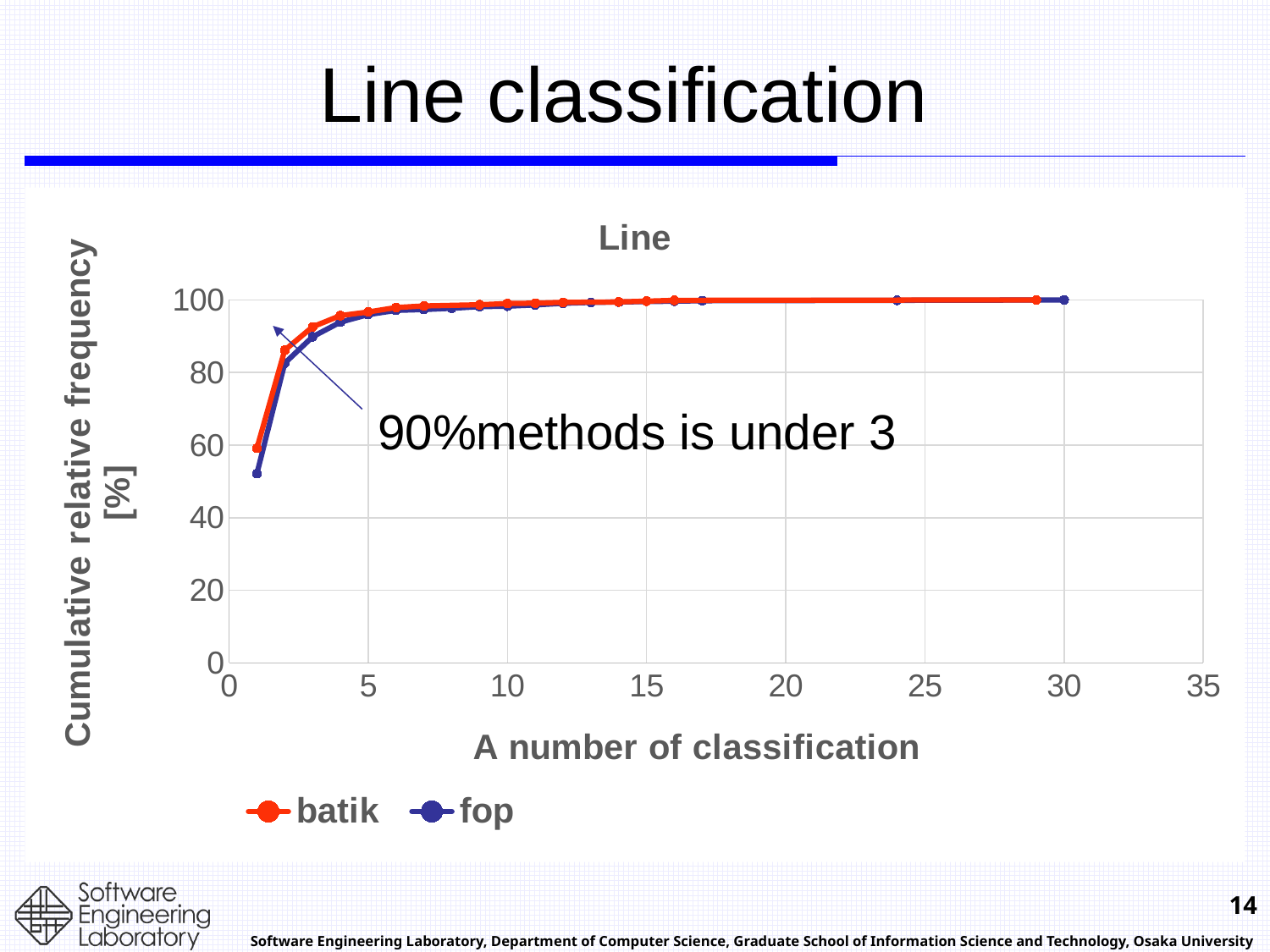
Do the values for batik rise or fall as the number of classification increases? rise Is the value for fop at a number of classification of 1 greater or less than 40? greater At a number of classification of 1, which series has the higher cumulative relative frequency, batik or fop? batik Is the value for batik at a number of classification of 2 greater or less than 80? greater Is the value for fop at a number of classification of 10 greater or less than 80? greater How many series does the legend list? 2 What kind of chart is shown on the slide? line chart What is the label of the x axis? A number of classification What is the title of the chart? Line Do the values for fop rise or fall along the x axis? rise